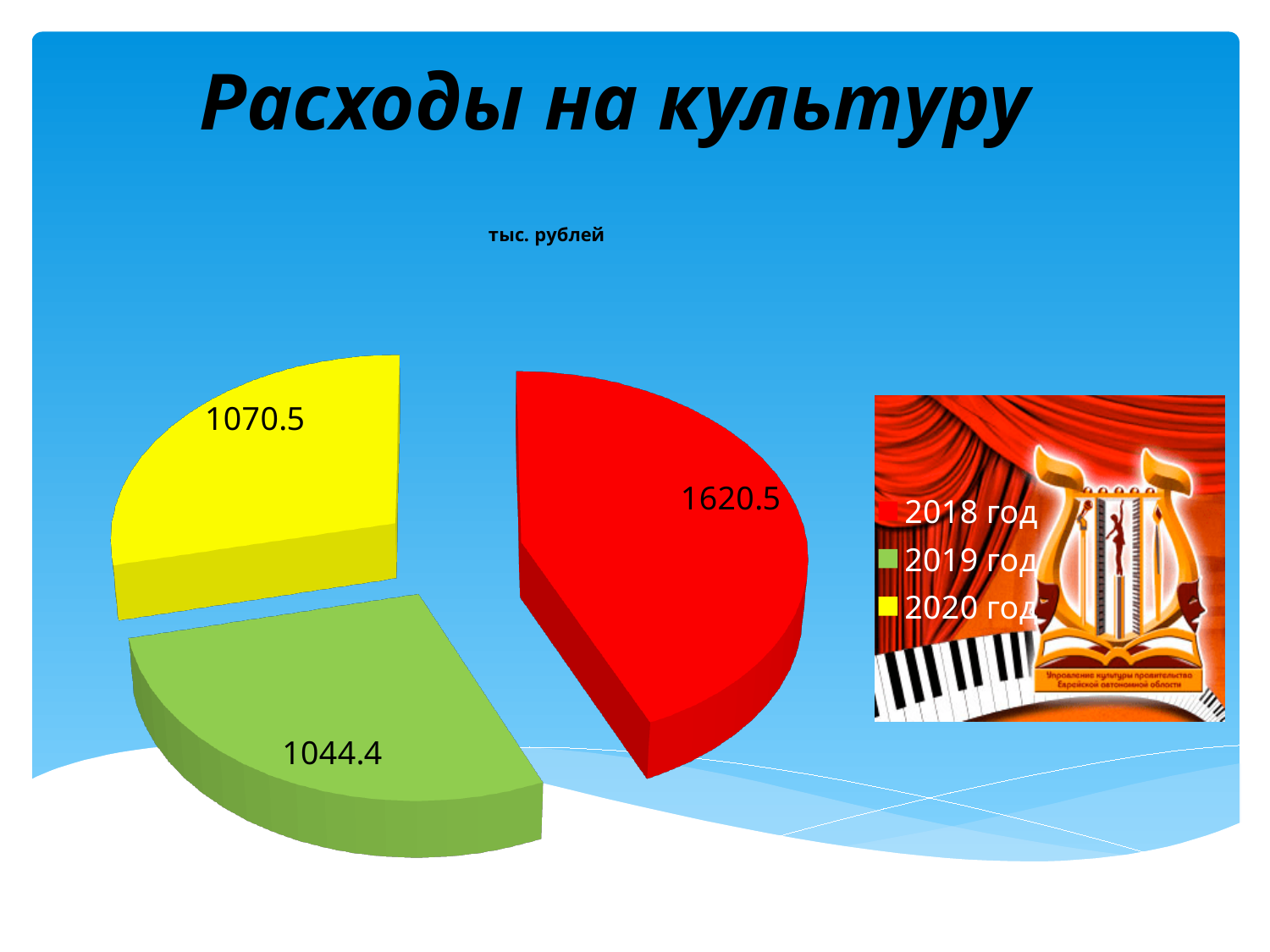
Which is larger, the value for 2019 год or the value for 2020 год? 2020 год What is the value for 2019 год? 1044.4 What is the difference between the values for 2020 год and 2019 год? 26.1 What kind of chart is shown on the slide? pie chart What is the title of the slide? Расходы на культуру How many slices does the pie chart have? 3 Which year has the smallest slice of the pie? 2019 год What is the difference between the values for 2018 год and 2019 год? 576.1 What colour is the slice for 2020 год? yellow Which year has the largest slice of the pie? 2018 год What is the value for 2020 год? 1070.5 What is the value for 2018 год? 1620.5